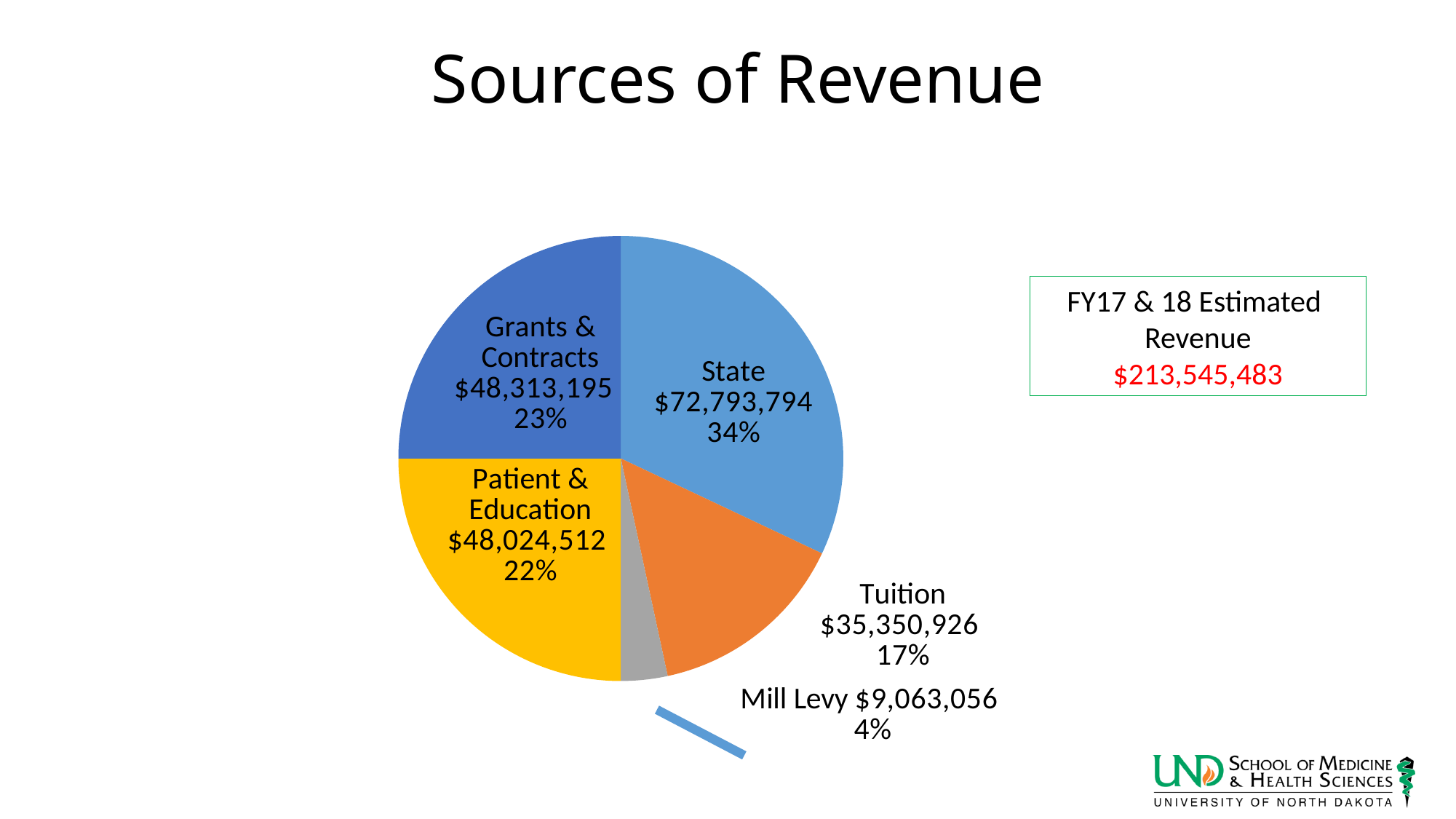
What kind of chart is shown on the slide? Pie chart How many slices does the pie chart have? 5 Which source of revenue is the largest? State What is the revenue value for State? $72,793,794 What is the title of the slide's chart? Sources of Revenue What is the difference between the State and Tuition revenue values? $37,442,868 What is the revenue value for Mill Levy? $9,063,056 Which source of revenue is the smallest? Mill Levy What is the revenue value for Tuition? $35,350,926 What share of the pie does Grants & Contracts represent? 23% Which is larger, State or Tuition? State What share of the pie does Patient & Education represent? 22%